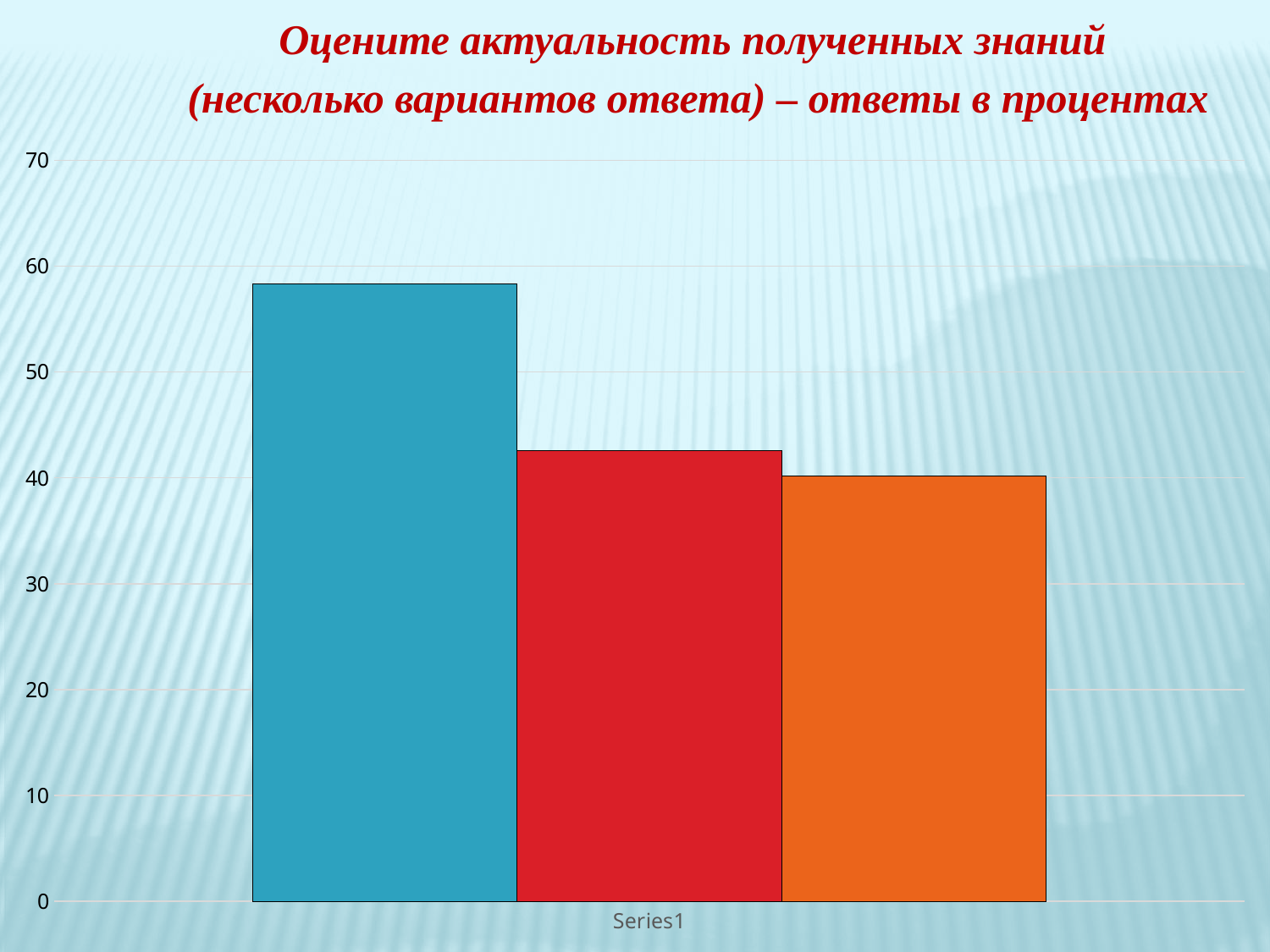
How many bars are plotted in the chart? 3 Is the value of the orange (rightmost) bar greater or less than 50? less Is the value of the blue (leftmost) bar greater or less than 50? greater Is the value of the red (middle) bar greater or less than 50? less Do the bar values rise or fall from left to right across the chart? fall What kind of chart is shown on the slide? bar chart What is the highest value shown on the vertical axis of the chart? 70 Which is larger, the blue (leftmost) bar or the orange (rightmost) bar? the blue (leftmost) bar Which bar is the tallest in the chart? the blue (leftmost) bar What label is shown under the bars on the x axis? Series1